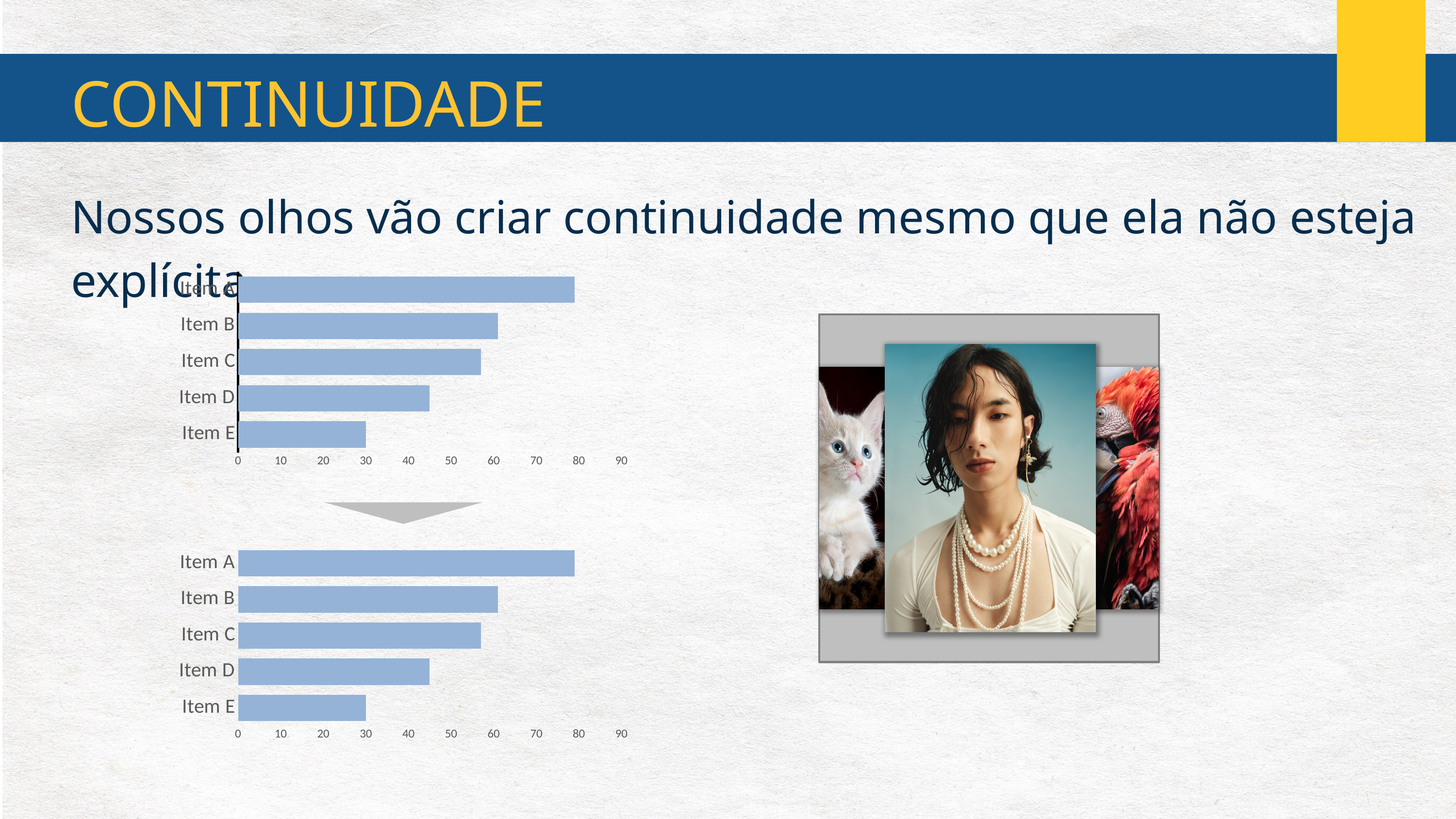
What kind of chart is the top chart on the slide? bar chart In the bottom chart, which is larger, the value for Item C or the value for Item D? Item C In the bottom chart, do the bar values rise or fall going from Item A down to Item E? fall In the bottom chart, which item has the lowest value? Item E In the top chart, is the value for Item A greater or less than 70? greater In the bottom chart, is the value for Item D greater or less than 50? less Which of the two charts has a vertical axis line drawn next to the category labels, the top or the bottom one? the top one In the top chart, which item has the highest value? Item A In the top chart, which is larger, the value for Item B or the value for Item E? Item B What is the highest tick value shown on the horizontal axis of the bottom chart? 90 How many categories does the bottom chart show? 5 In the top chart, is the value for Item B greater or less than 50? greater